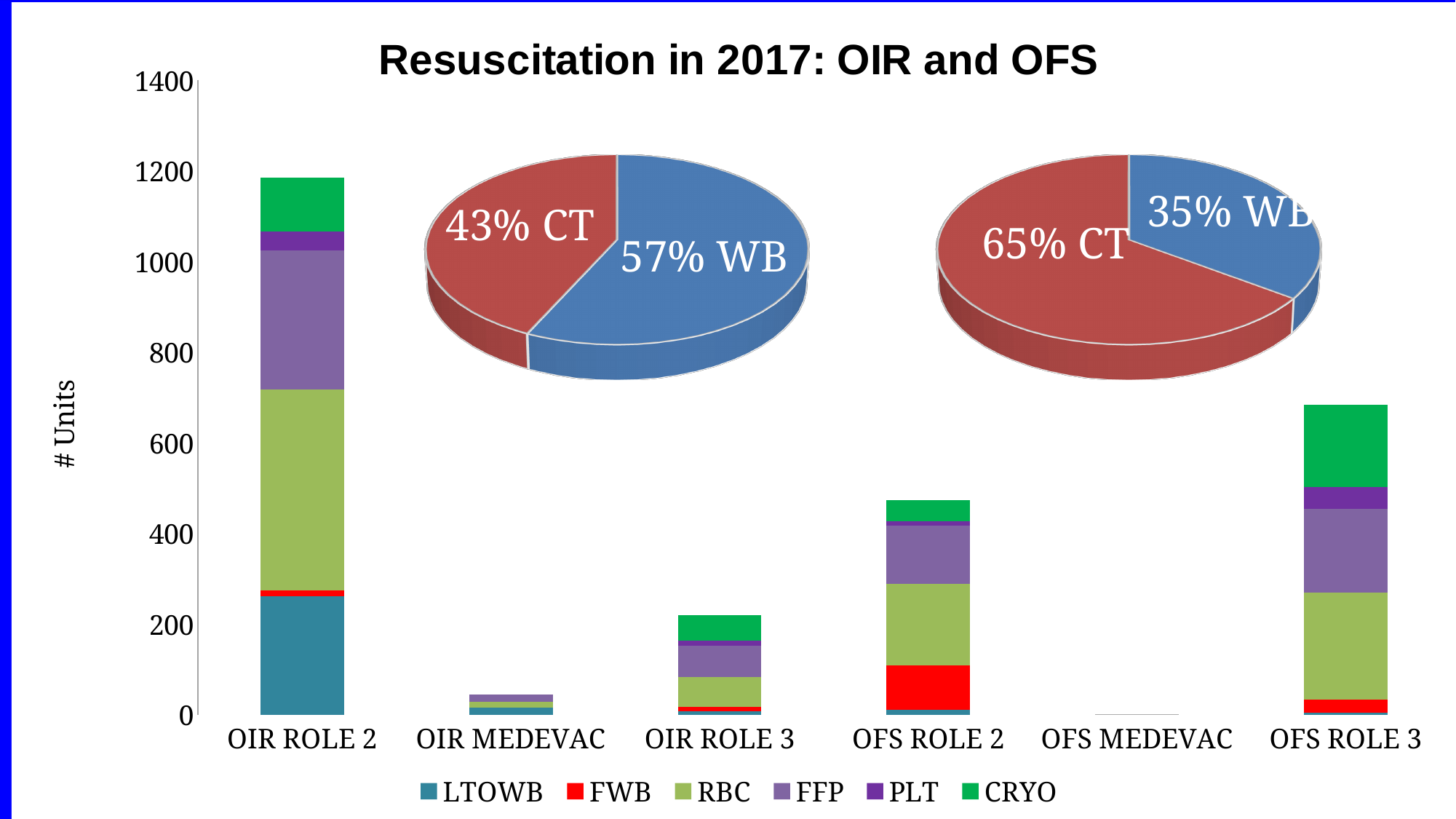
In the right pie chart, what share is labelled CT? 65% CT In the bar chart, which category has the tallest stacked bar? OIR ROLE 2 What is the title of the bar chart on the slide? Resuscitation in 2017: OIR and OFS How many categories are shown on the x axis of the bar chart? 6 In the left pie chart, what share is labelled WB? 57% WB In the bar chart, is the total for OFS ROLE 3 greater or less than 600? greater What kind of chart is the large chart with the # Units axis? stacked bar chart In the bar chart, is the total for OIR MEDEVAC greater or less than 200? less In the bar chart, which has the larger total, OFS ROLE 2 or OFS ROLE 3? OFS ROLE 3 In the bar chart, which category has the smallest total? OFS MEDEVAC In the bar chart, is the total for OIR ROLE 2 greater or less than 1000? greater How many series does the legend of the bar chart list? 6